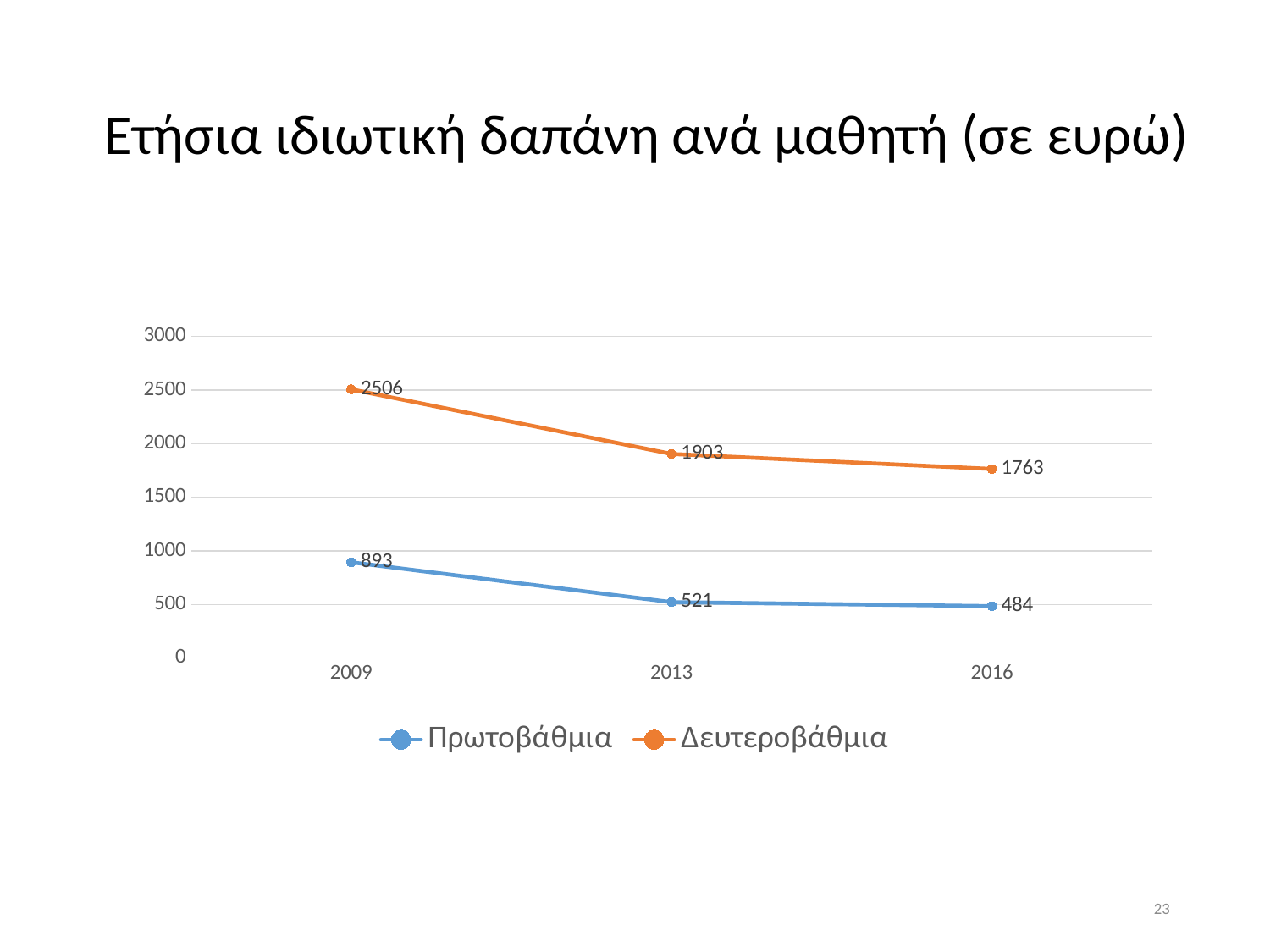
How many series does the legend list? 2 By how much did the Πρωτοβάθμια value fall from 2009 to 2013? 372 In which year is the Πρωτοβάθμια value lowest? 2016 What kind of chart is shown on the slide? Line chart What is the value for Δευτεροβάθμια in 2013? 1903 In which year is the Δευτεροβάθμια value highest? 2009 What is the value for Πρωτοβάθμια in 2016? 484 How many years are shown on the x axis? 3 What is the difference between the Δευτεροβάθμια and Πρωτοβάθμια values in 2009? 1613 Which series has the larger value in 2013, Πρωτοβάθμια or Δευτεροβάθμια? Δευτεροβάθμια What is the value for Πρωτοβάθμια in 2009? 893 What is the value for Δευτεροβάθμια in 2016? 1763